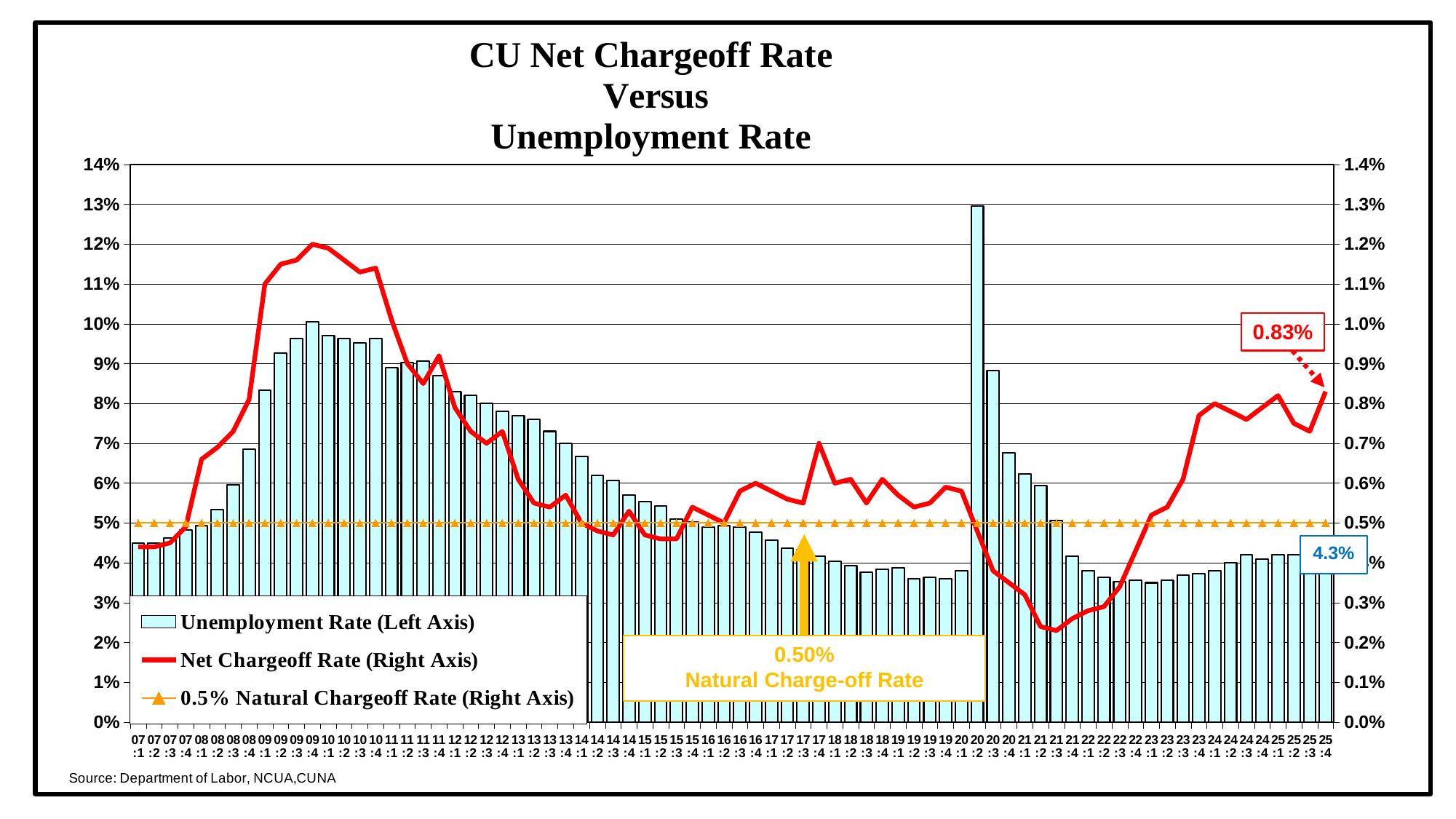
Is the Net Chargeoff Rate for 09:4 greater or less than 1.1%? greater Is the Net Chargeoff Rate for 21:3 greater or less than 0.3%? less Does the Net Chargeoff Rate rise or fall from 21:3 to 24:1? rises What is the title of the chart? CU Net Chargeoff Rate Versus Unemployment Rate What kind of chart is shown? Combination bar and line chart What value is given for the Natural Charge-off Rate? 0.50% How many series does the legend list? 3 What is the Net Chargeoff Rate labelled for 25:4? 0.83% Which is larger: the Net Chargeoff Rate at 25:4 or the 0.5% Natural Chargeoff Rate? Net Chargeoff Rate at 25:4 In which quarter is the Unemployment Rate bar highest? 20:2 Is the Unemployment Rate for 20:2 greater or less than 12%? greater What is the Unemployment Rate labelled for 25:4? 4.3%